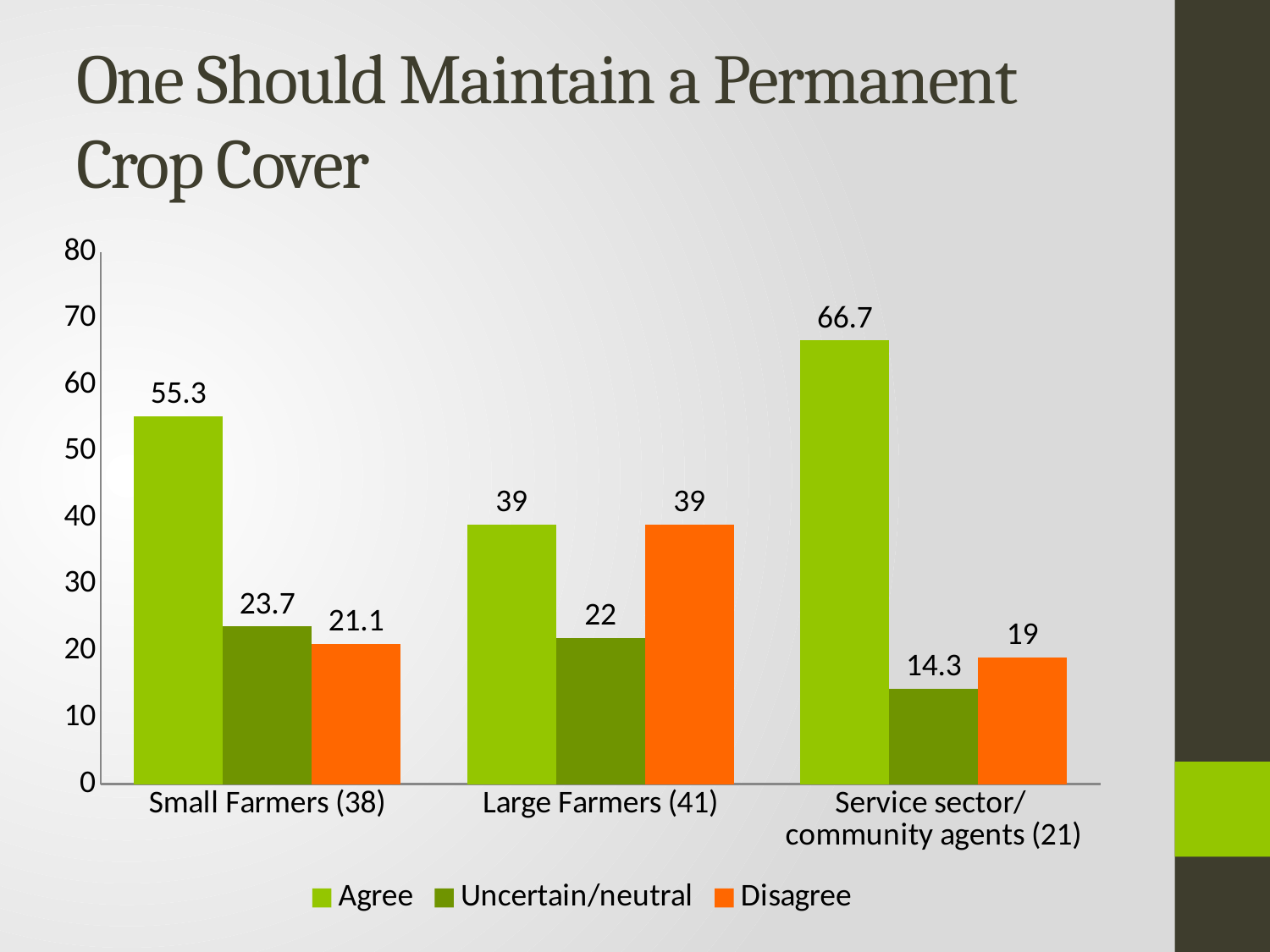
Which category has the highest Agree value? Service sector/ community agents (21) How many categories are shown on the x axis? 3 Which category has the lowest Uncertain/neutral value? Service sector/ community agents (21) What colour represents the Disagree series? orange What is the Agree value for Small Farmers (38)? 55.3 What is the Disagree value for Large Farmers (41)? 39 How many series does the legend list? 3 Which is larger for Small Farmers (38): the Uncertain/neutral value or the Disagree value? Uncertain/neutral What is the difference between the Agree values for Service sector/ community agents (21) and Small Farmers (38)? 11.4 What is the Uncertain/neutral value for Service sector/ community agents (21)? 14.3 What kind of chart is shown on the slide? bar chart Is the Agree value for Large Farmers (41) greater or less than 40? less